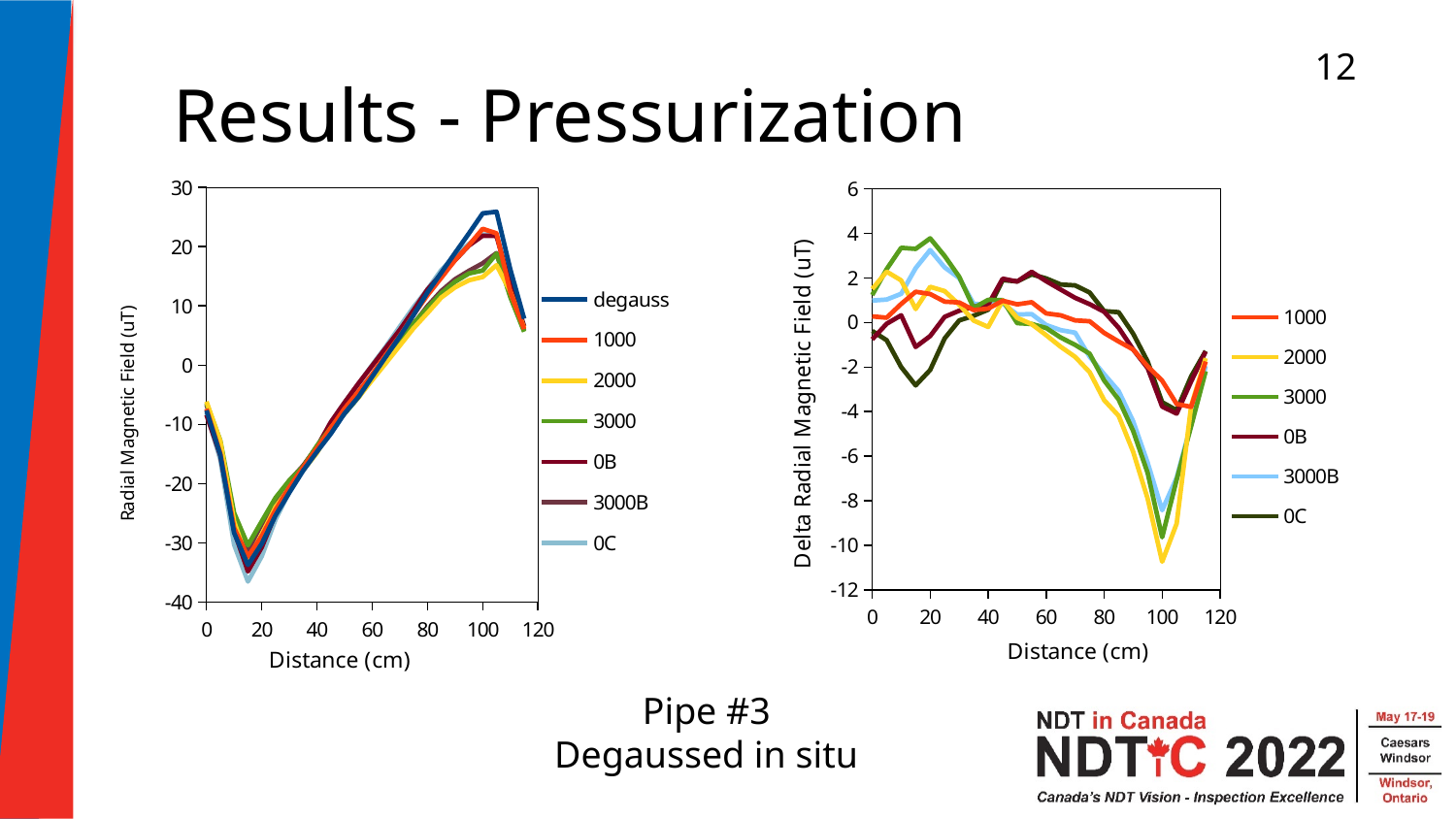
On the left chart, is the value of the degauss series at 100 cm greater or less than 20? greater On the right chart, do the values fall or rise along the x axis between 60 cm and 100 cm? fall On the right chart, at 100 cm, which series has the larger value: 1000 or 2000? 1000 On the right chart, is the value of the 2000 series at 100 cm greater or less than -10? less How many series does the legend of the right chart (Delta Radial Magnetic Field) list? 6 On the left chart, do the values rise or fall along the x axis between 20 cm and 100 cm? rise On the right chart, is the value of the 3000 series at 20 cm greater or less than 2? greater What is the y-axis label of the right chart? Delta Radial Magnetic Field (uT) What kind of chart is the left chart (Radial Magnetic Field vs Distance)? line chart How many series does the legend of the left chart list? 7